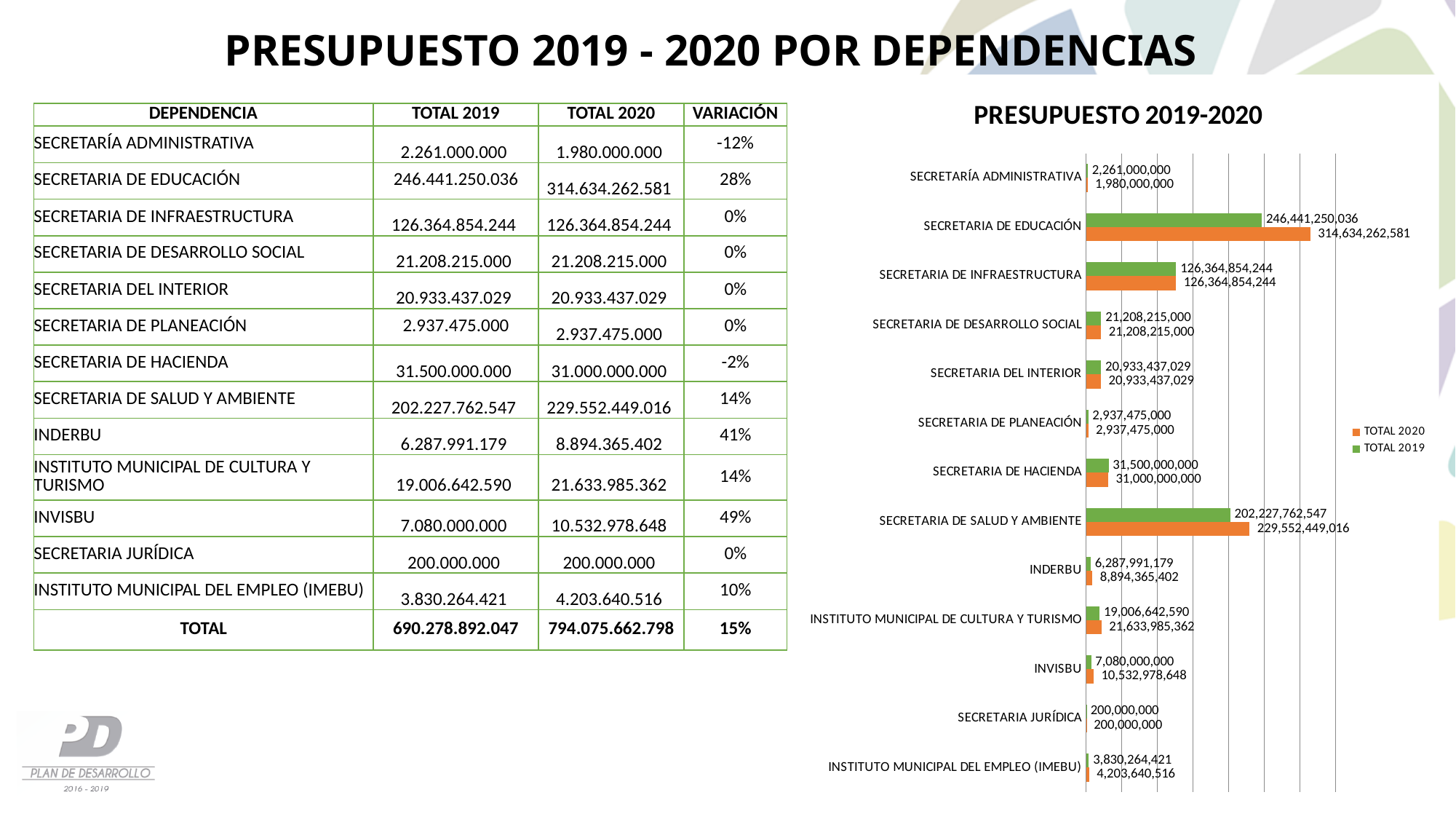
In the PRESUPUESTO 2019-2020 chart, what is the difference between the TOTAL 2019 and TOTAL 2020 values for SECRETARÍA ADMINISTRATIVA? 281,000,000 In the PRESUPUESTO 2019-2020 chart, which dependencia has the highest TOTAL 2020 value? SECRETARIA DE EDUCACIÓN In the PRESUPUESTO 2019-2020 chart, which is larger for INDERBU, TOTAL 2019 or TOTAL 2020? TOTAL 2020 What kind of chart is the PRESUPUESTO 2019-2020 chart? Bar chart In the PRESUPUESTO 2019-2020 chart, which is larger for SECRETARIA DE HACIENDA, TOTAL 2019 or TOTAL 2020? TOTAL 2019 In the PRESUPUESTO 2019-2020 chart, what is the TOTAL 2020 value for SECRETARIA DE EDUCACIÓN? 314,634,262,581 In the PRESUPUESTO 2019-2020 chart, what colour represents the TOTAL 2020 series? Orange In the PRESUPUESTO 2019-2020 chart, which dependencia has the lowest TOTAL 2019 value? SECRETARIA JURÍDICA How many dependencias are shown in the PRESUPUESTO 2019-2020 chart? 13 How many series does the legend of the PRESUPUESTO 2019-2020 chart list? 2 In the PRESUPUESTO 2019-2020 chart, what is the TOTAL 2019 value for INVISBU? 7,080,000,000 In the PRESUPUESTO 2019-2020 chart, what is the difference between the TOTAL 2020 and TOTAL 2019 values for SECRETARIA DE SALUD Y AMBIENTE? 27,324,686,469